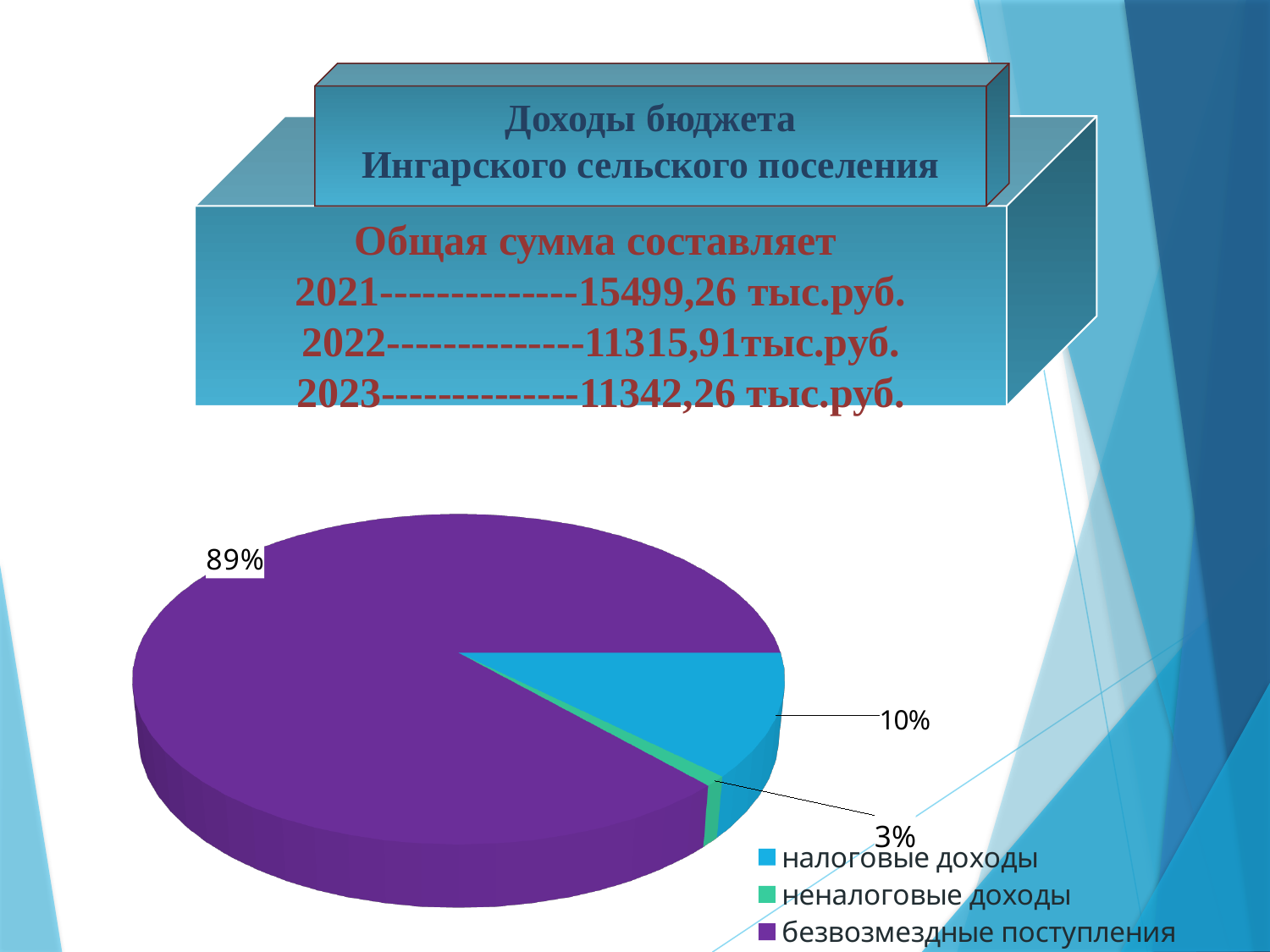
What share of the pie does налоговые доходы have? 10% Which category has the largest slice of the pie? безвозмездные поступления Which category has the smallest slice of the pie? неналоговые доходы What is the difference in percentage points between the безвозмездные поступления slice and the налоговые доходы slice? 79 How many entries does the legend list? 3 How many slices does the pie chart have? 3 What share of the pie does безвозмездные поступления have? 89% What is the difference in percentage points between the налоговые доходы slice and the неналоговые доходы slice? 7 What colour is the slice for безвозмездные поступления? purple What share of the pie does неналоговые доходы have? 3% Which is larger, the slice for налоговые доходы or the slice for неналоговые доходы? налоговые доходы What kind of chart is shown on the slide? pie chart